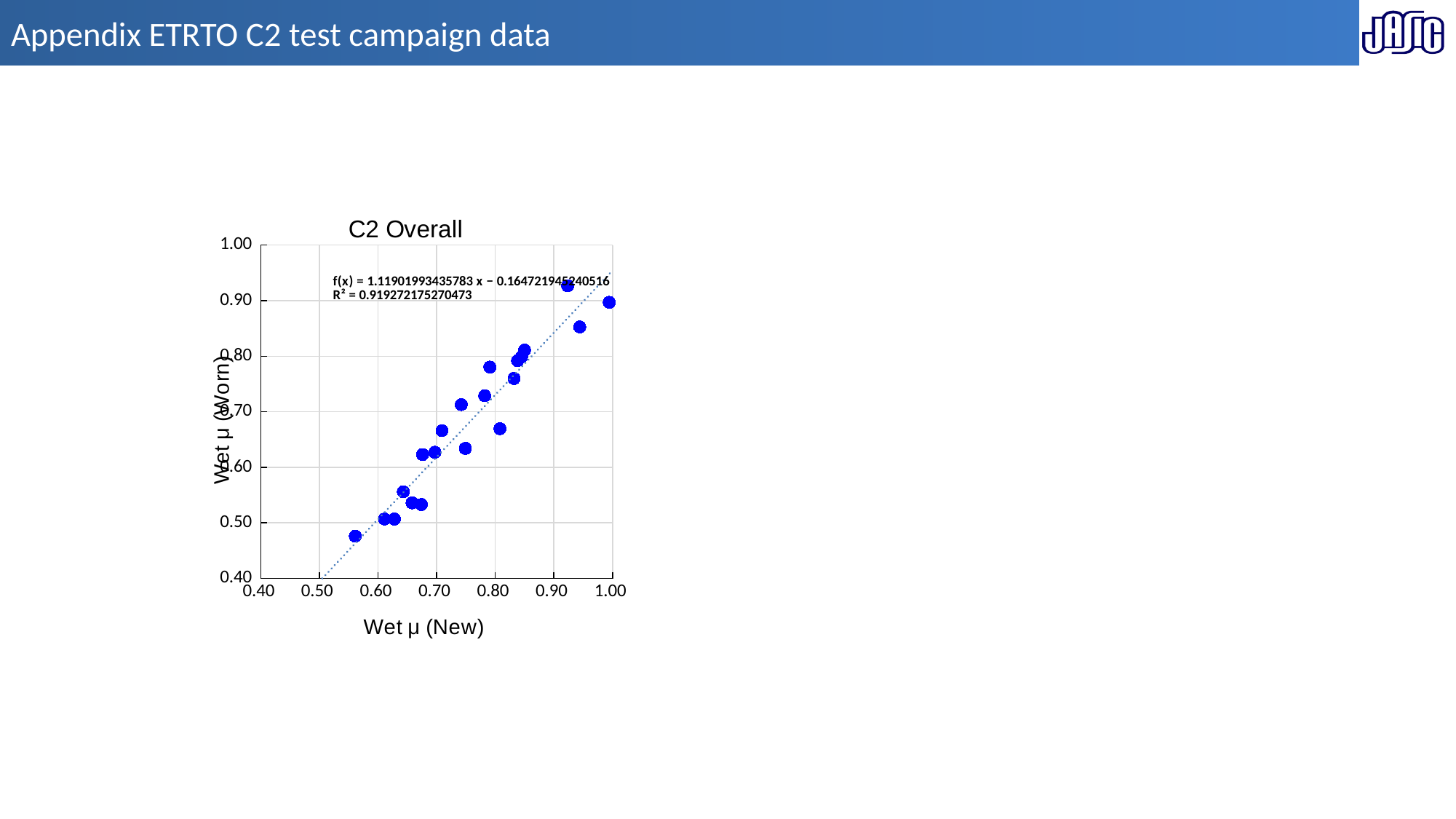
Is the Wet μ (Worn) value of the point with the lowest Wet μ (New) greater or less than 0.60? less What is the slope (coefficient of x) in the trendline equation printed on the chart? 1.11901993435783 What is the label of the x axis of the chart? Wet μ (New) Is the highest plotted Wet μ (Worn) value greater or less than 0.90? greater Is the lowest plotted Wet μ (Worn) value greater or less than 0.50? less What R² value is printed on the chart for the trendline? 0.919272175270473 What kind of chart is shown on the slide? Scatter chart What is the title of the chart? C2 Overall As Wet μ (New) increases along the x axis, do the Wet μ (Worn) values generally rise or fall? Rise